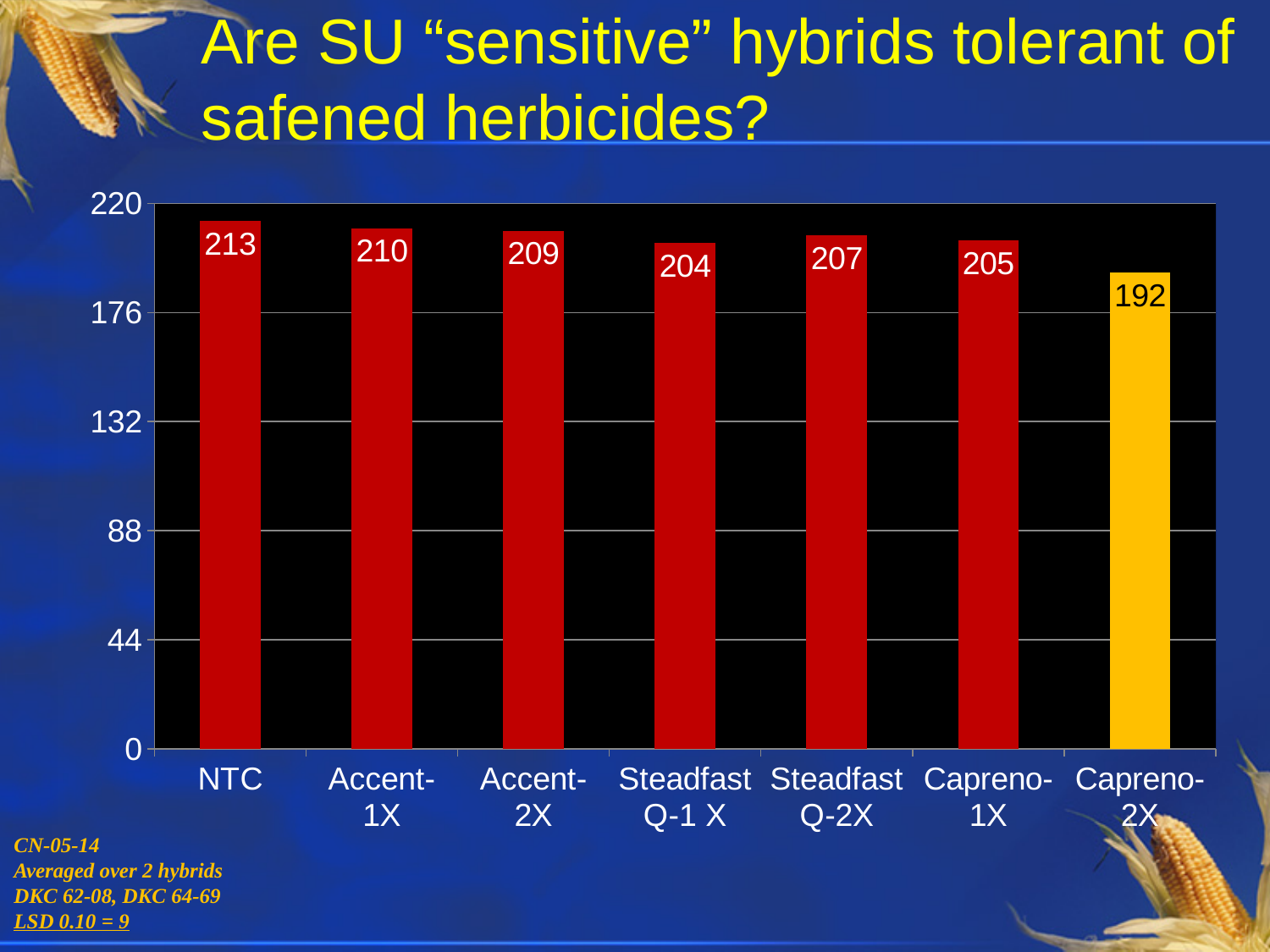
What is the difference between the values for NTC and Capreno-2X? 21 What kind of chart is shown on the slide? bar chart What is the difference between the values for Accent-1X and Accent-2X? 1 How many categories are shown on the x axis? 7 Which bar is coloured differently from the others? Capreno-2X Is the value for Capreno-1X greater or less than 176? greater What is the value for Steadfast Q-1 X? 204 Which category has the highest value? NTC What is the value for Capreno-2X? 192 What is the value for NTC? 213 Which is larger, the value for Steadfast Q-2X or the value for Capreno-2X? Steadfast Q-2X Which category has the lowest value? Capreno-2X